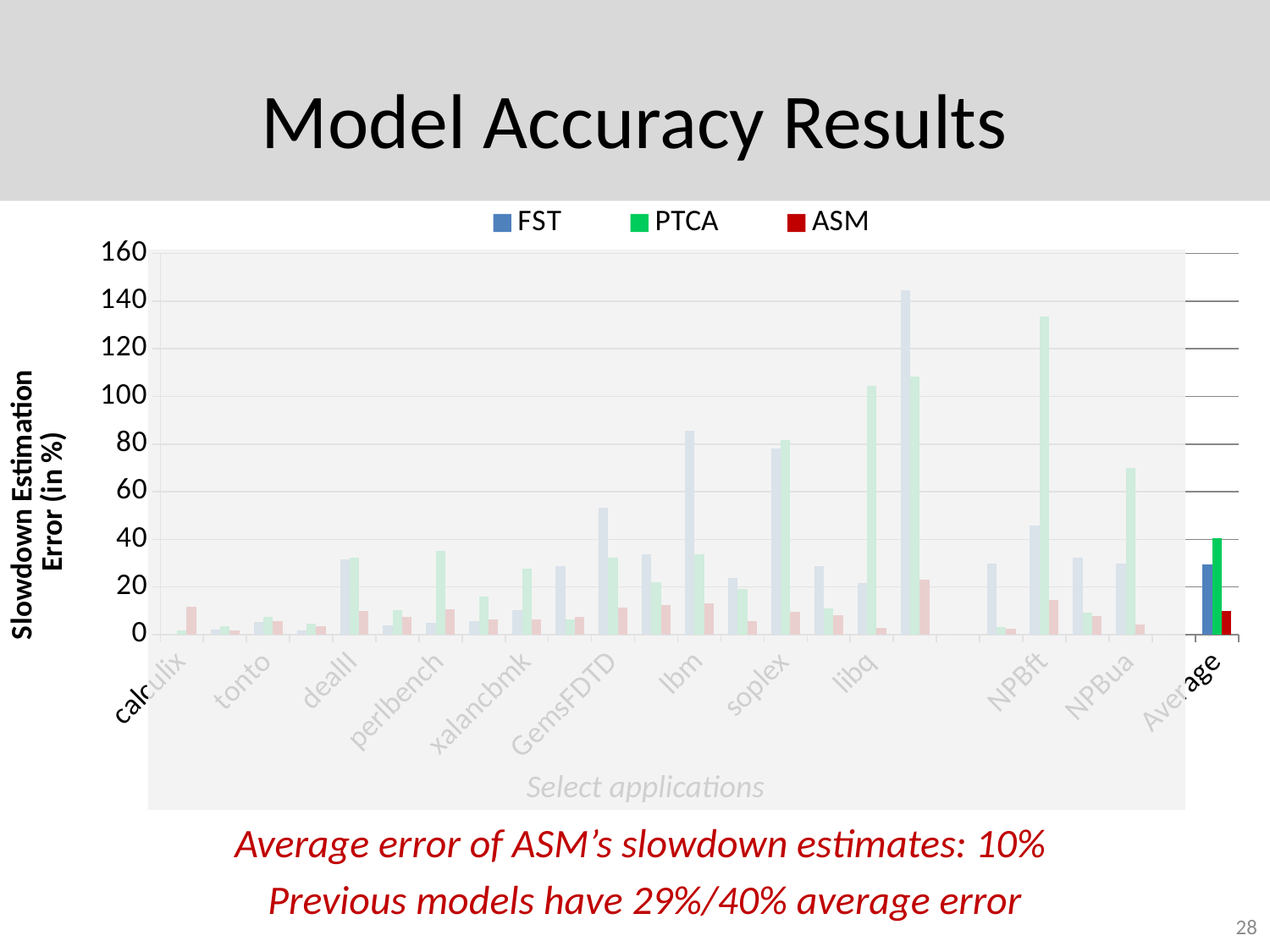
Which series has the highest value in the Average group? PTCA What kind of chart is shown on the slide? bar chart What is the average error for the PTCA model according to the slide? 40% How many series does the legend list? 3 In the Average group, is the FST bar or the PTCA bar taller? PTCA Which series has the lowest value in the Average group? ASM What is the average error for the FST model according to the slide? 29% What is the average error of ASM's slowdown estimates shown on the slide? 10% What is the difference between the average error of PTCA and the average error of ASM? 30% What is the title of the vertical axis? Slowdown Estimation Error (in %) Is the value for ASM in the Average group greater or less than 20? less Is the value for FST in the Average group greater or less than 20? greater